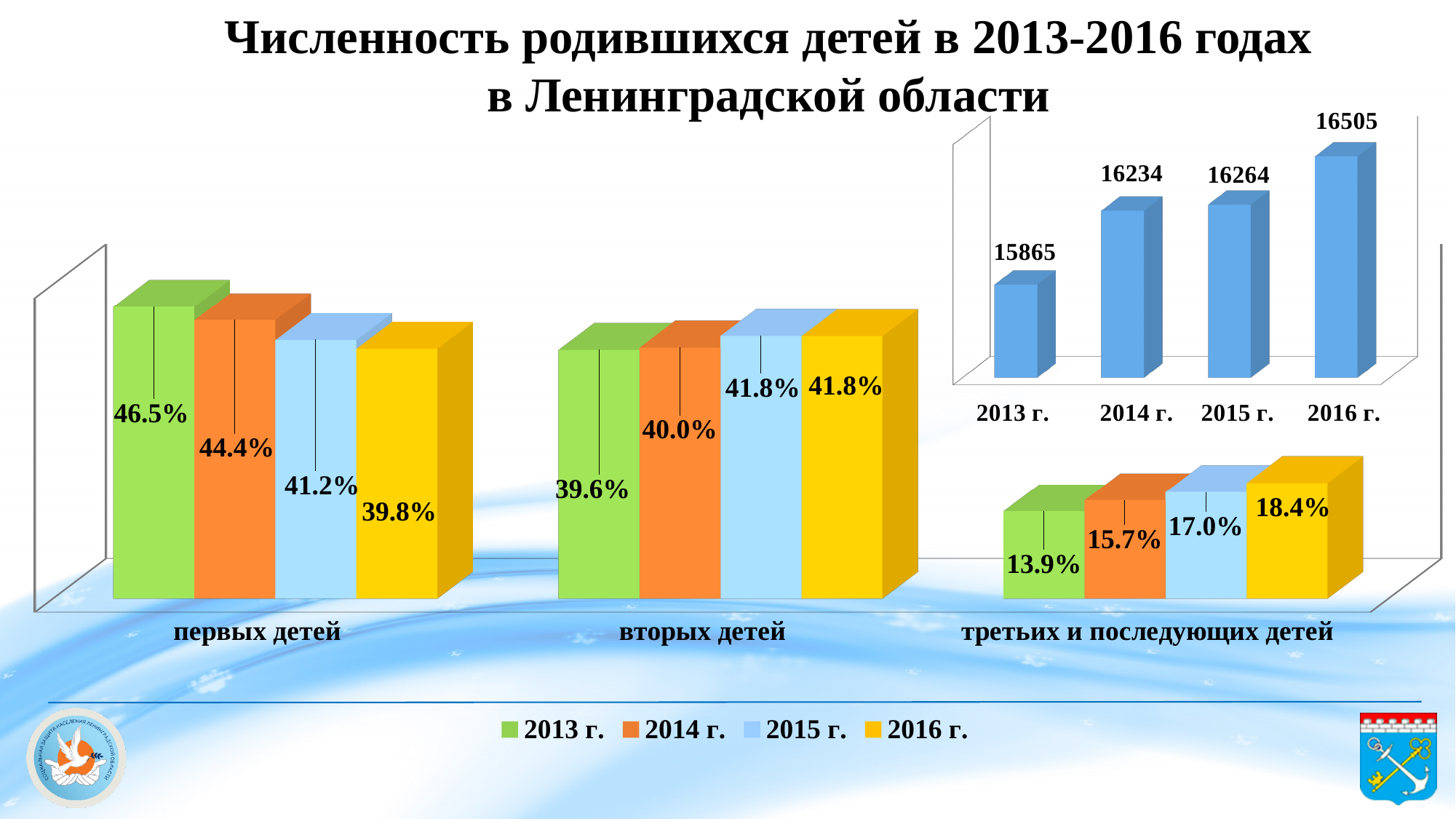
In the large grouped bar chart, which year has the lowest value for третьих и последующих детей? 2013 г. In the large grouped bar chart, what is the difference between the 2013 г. and 2016 г. values for первых детей? 6.7% In the large grouped bar chart, which year has the highest value for первых детей? 2013 г. In the large grouped bar chart, what is the value for 2014 г. for вторых детей? 40.0% What kind of chart is the small chart at the top right? bar chart In the large grouped bar chart, do the values for третьих и последующих детей rise or fall from 2013 г. to 2016 г.? rise In the large grouped bar chart, how many series does the legend list? 4 In the small chart at the top right, which year has the lowest value? 2013 г. In the large grouped bar chart, what is the value for 2016 г. for третьих и последующих детей? 18.4% In the large grouped bar chart, what is the value for 2013 г. for первых детей? 46.5% In the small chart at the top right, what is the difference between the values for 2016 г. and 2013 г.? 640 In the small chart at the top right, what is the value for 2016 г.? 16505